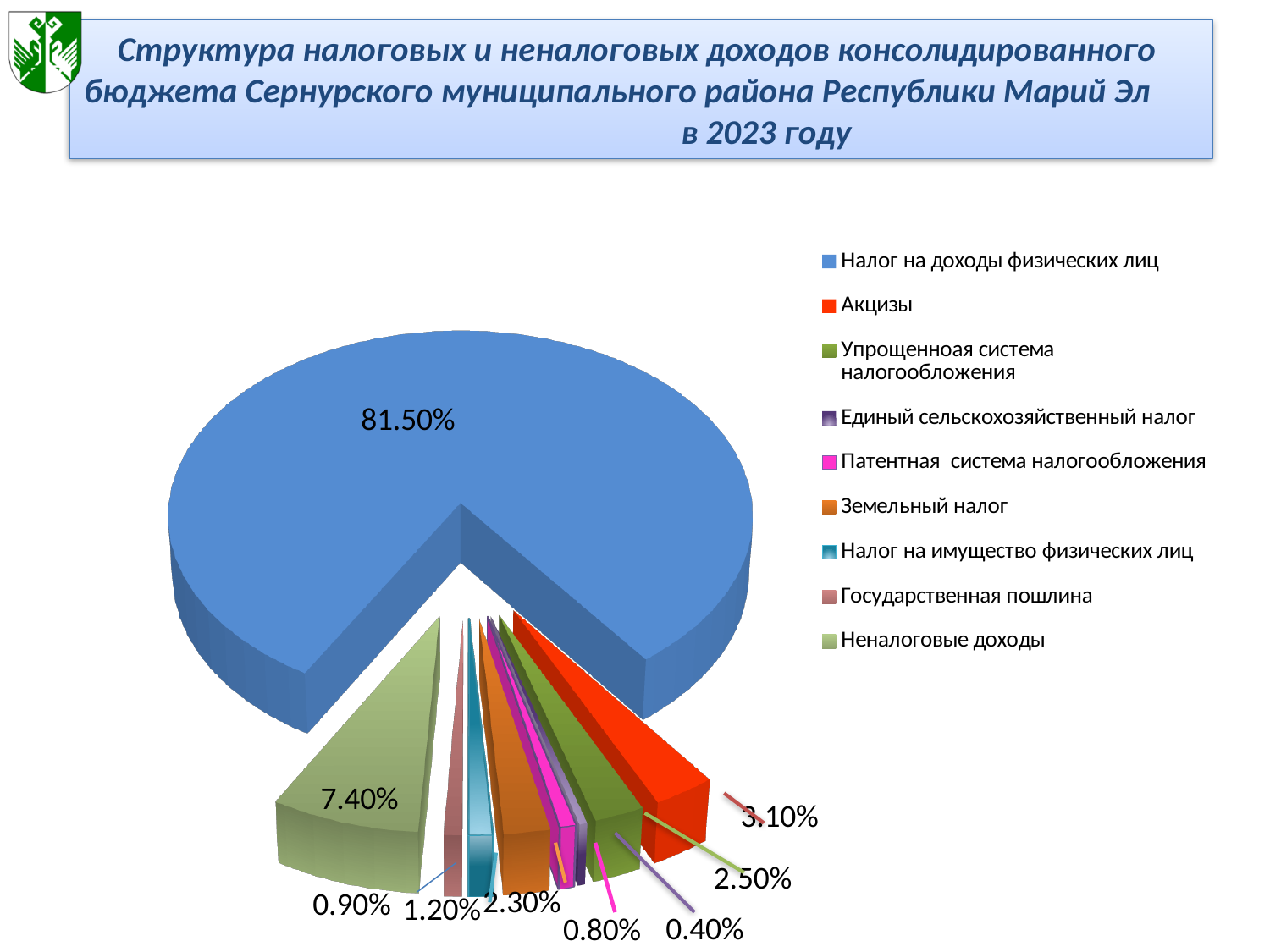
What is the value shown for Земельный налог? 2.30% What kind of chart is shown on the slide? Pie chart Which category has the largest share of the pie? Налог на доходы физических лиц Which is larger, the share of Налог на имущество физических лиц or the share of Государственная пошлина? Налог на имущество физических лиц What is the value shown for Акцизы? 3.10% How many categories does the legend list? 9 Which category has the smallest share of the pie? Единый сельскохозяйственный налог What colour is the slice for Патентная система налогообложения? Magenta (pink) What share of the pie does Налог на доходы физических лиц have? 81.50% What is the value shown for Неналоговые доходы? 7.40% What is the difference between the shares of Неналоговые доходы and Акцизы? 4.30% What is the value shown for Единый сельскохозяйственный налог? 0.40%